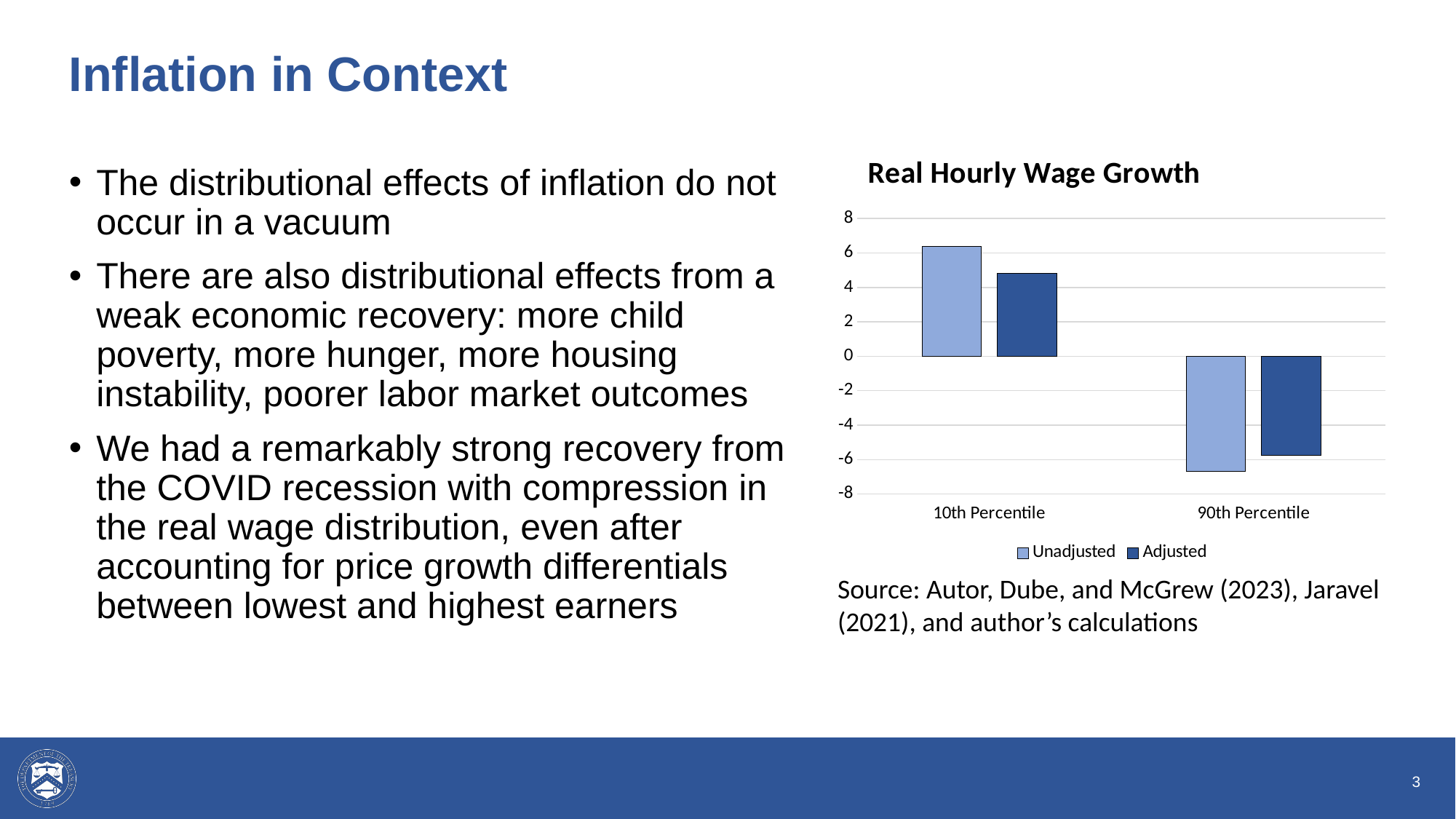
Is the Adjusted value for the 90th Percentile greater or less than -4? less Is the Unadjusted value for the 10th Percentile greater or less than 4? greater Is the Adjusted value for the 10th Percentile greater or less than 6? less How many series does the chart's legend list? 2 How many categories are shown on the x axis of the chart? 2 What is the title of the chart? Real Hourly Wage Growth For the 90th Percentile, which is larger: the Unadjusted or the Adjusted value? Adjusted Which series and category has the highest value in the chart? Unadjusted, 10th Percentile Which series and category has the lowest value in the chart? Unadjusted, 90th Percentile What kind of chart is shown on the slide? Bar chart For the 10th Percentile, which is larger: the Unadjusted or the Adjusted value? Unadjusted